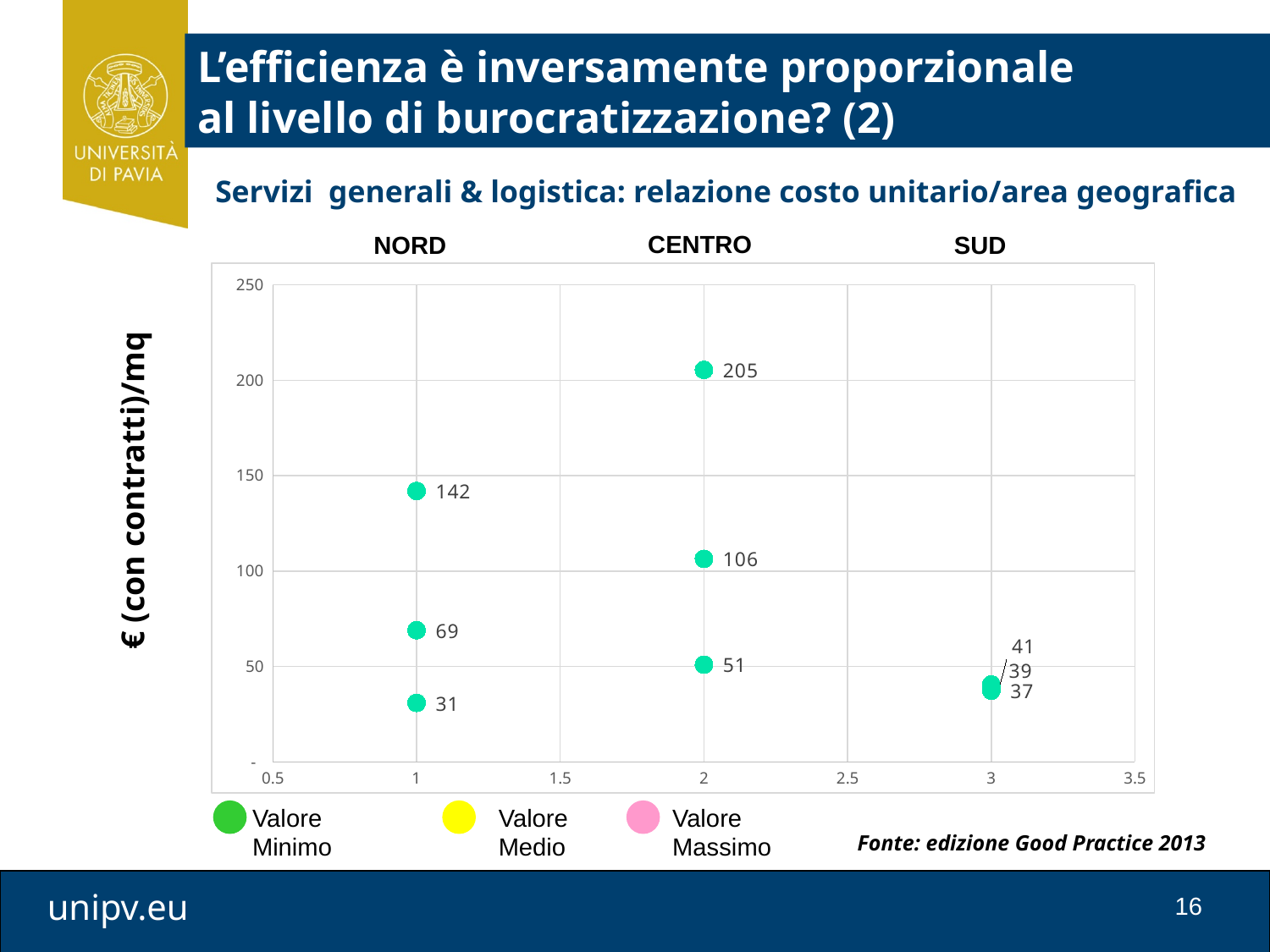
What is the lowest plotted value for NORD? 31 How many series does the legend list? 3 What is the label of the vertical axis? € (con contratti)/mq What is the difference between the highest value for CENTRO (205) and the highest value for NORD (142)? 63 What is the difference between the highest and lowest values plotted for SUD? 4 Which is larger: the middle value for CENTRO (106) or the middle value for NORD (69)? 106 (CENTRO) What kind of chart is shown on the slide? scatter chart What is the highest plotted value for SUD? 41 Which geographic area has the highest plotted value in the chart? CENTRO What is the highest plotted value for CENTRO? 205 Which geographic area has the lowest plotted value in the chart? NORD How many data points are plotted in the chart in total? 9